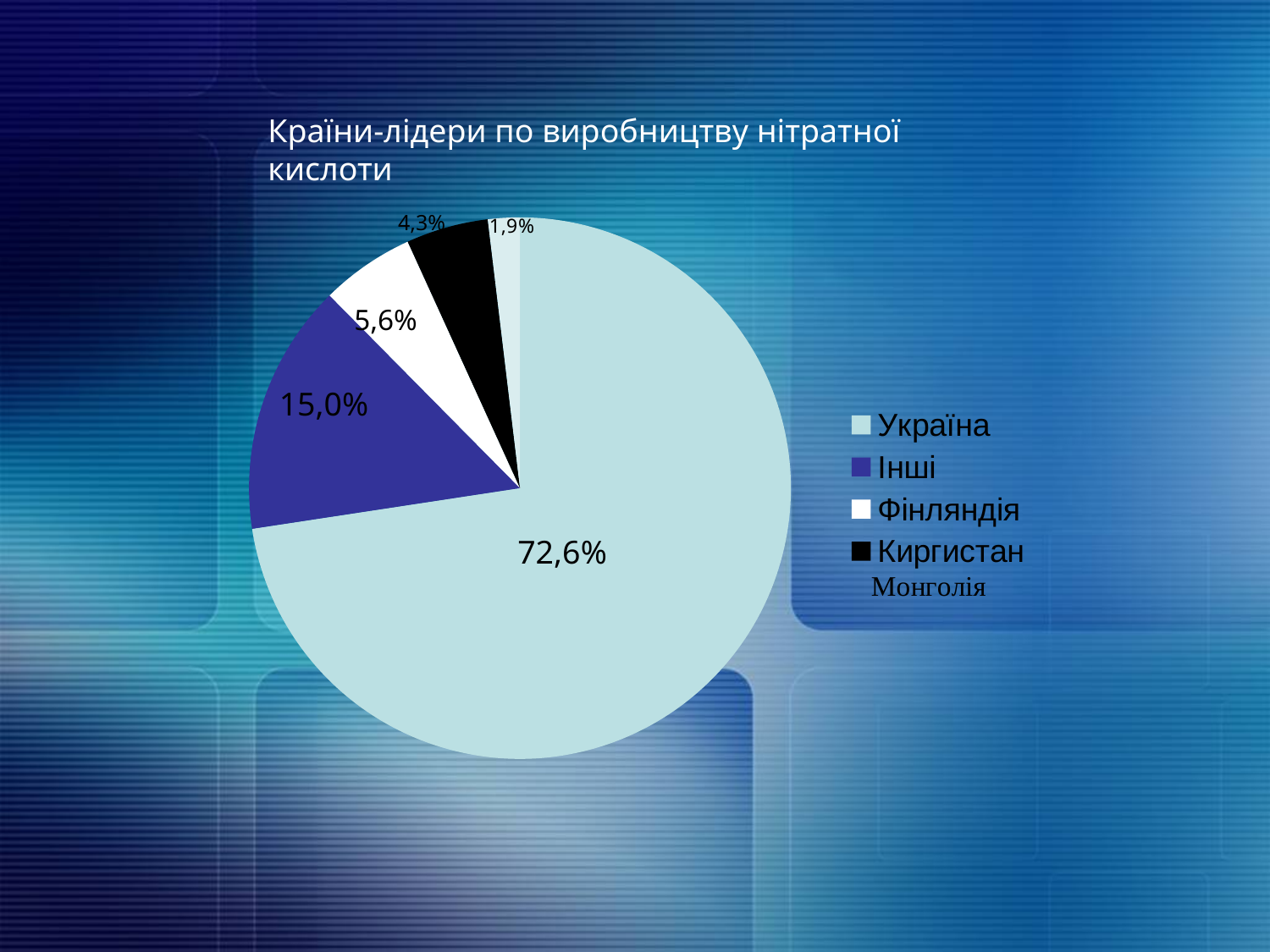
Which category has the largest slice of the pie? Україна What is the difference between the shares of Інші and Фінляндія? 9,4% What share of the pie does Киргистан have? 4,3% Which category has the smallest slice of the pie? Монголія What kind of chart is shown on the slide? Pie chart What is the title of the chart? Країни-лідери по виробництву нітратної кислоти What share of the pie does Фінляндія have? 5,6% Which is larger, the share of Фінляндія or the share of Киргистан? Фінляндія What share of the pie does Україна have? 72,6% How many slices does the pie chart have? 5